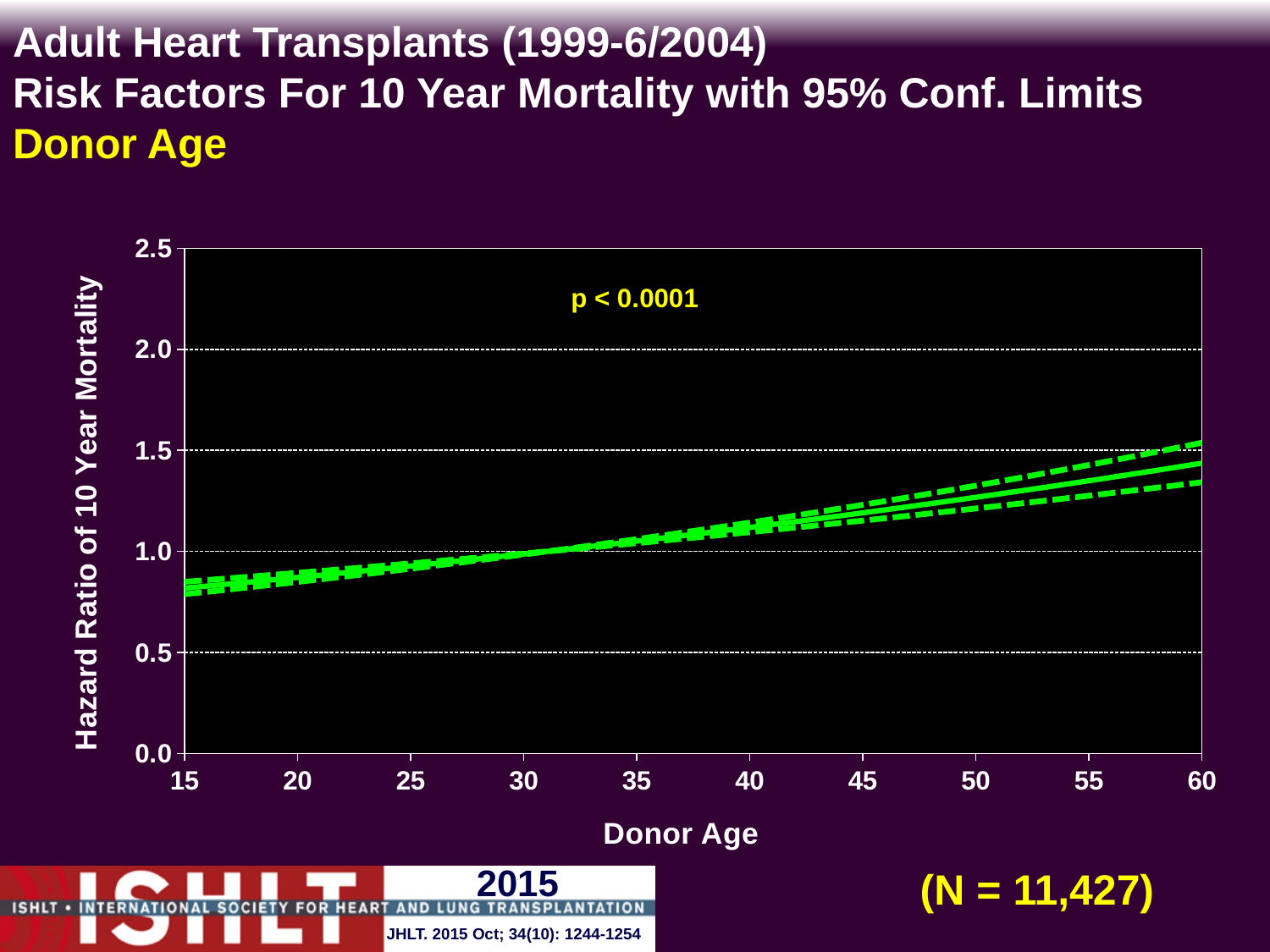
Is the hazard ratio for a donor age of 40 greater or less than 1.0? greater Does the hazard ratio of 10 year mortality rise or fall as donor age increases from 15 to 60? rise Is the hazard ratio for a donor age of 15 greater or less than 0.5? greater What is the sample size (N) shown on the slide? N = 11,427 Is the hazard ratio for a donor age of 15 greater or less than 1.0? less Which donor age has the higher hazard ratio, 20 or 55? 55 What is the label of the y axis? Hazard Ratio of 10 Year Mortality What is the highest value shown on the y axis? 2.5 What kind of chart is shown on the slide? line chart